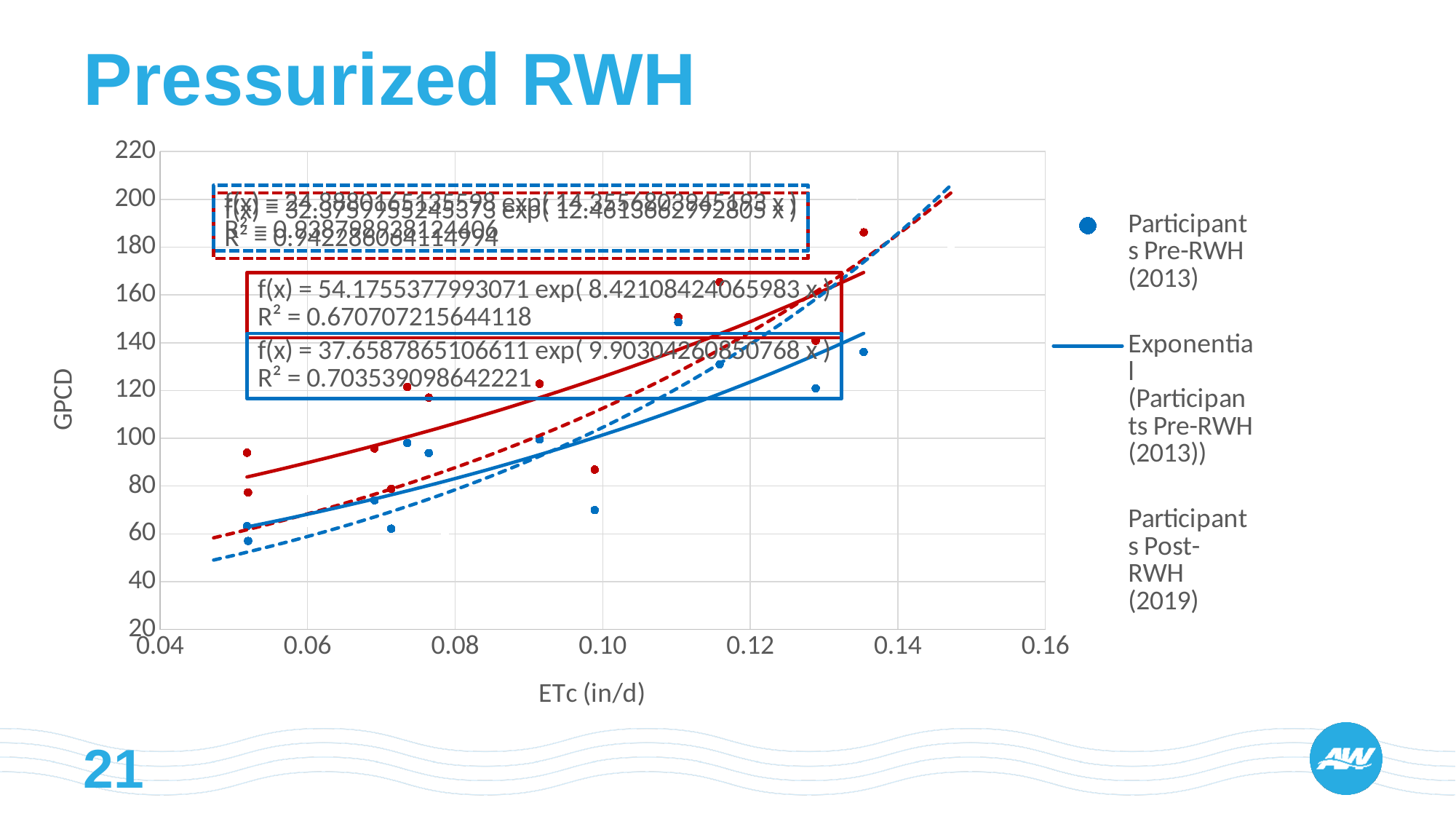
What is the R² value printed in the red-outlined equation box? 0.670707215644118 What kind of chart is shown on the slide? Scatter chart with exponential trendlines Does GPCD rise or fall as ETc increases along the x axis? Rises What is the title of the x axis of the chart? ETc (in/d) How many entries does the chart legend list? 3 At an ETc of about 0.10 in/d, which is higher: the red data point or the blue data point? The red data point Is the lowest blue data point on the chart greater or less than 80 GPCD? less What is the title of the y axis of the chart? GPCD What is the maximum value shown on the x axis of the chart? 0.16 What is the coefficient in front of exp in the equation f(x) = 54.1755377993071 exp( 8.42108424065983 x )? 54.1755377993071 Is the highest red data point on the chart greater or less than 160 GPCD? greater What is the R² value printed in the blue-outlined equation box? 0.703539098642221